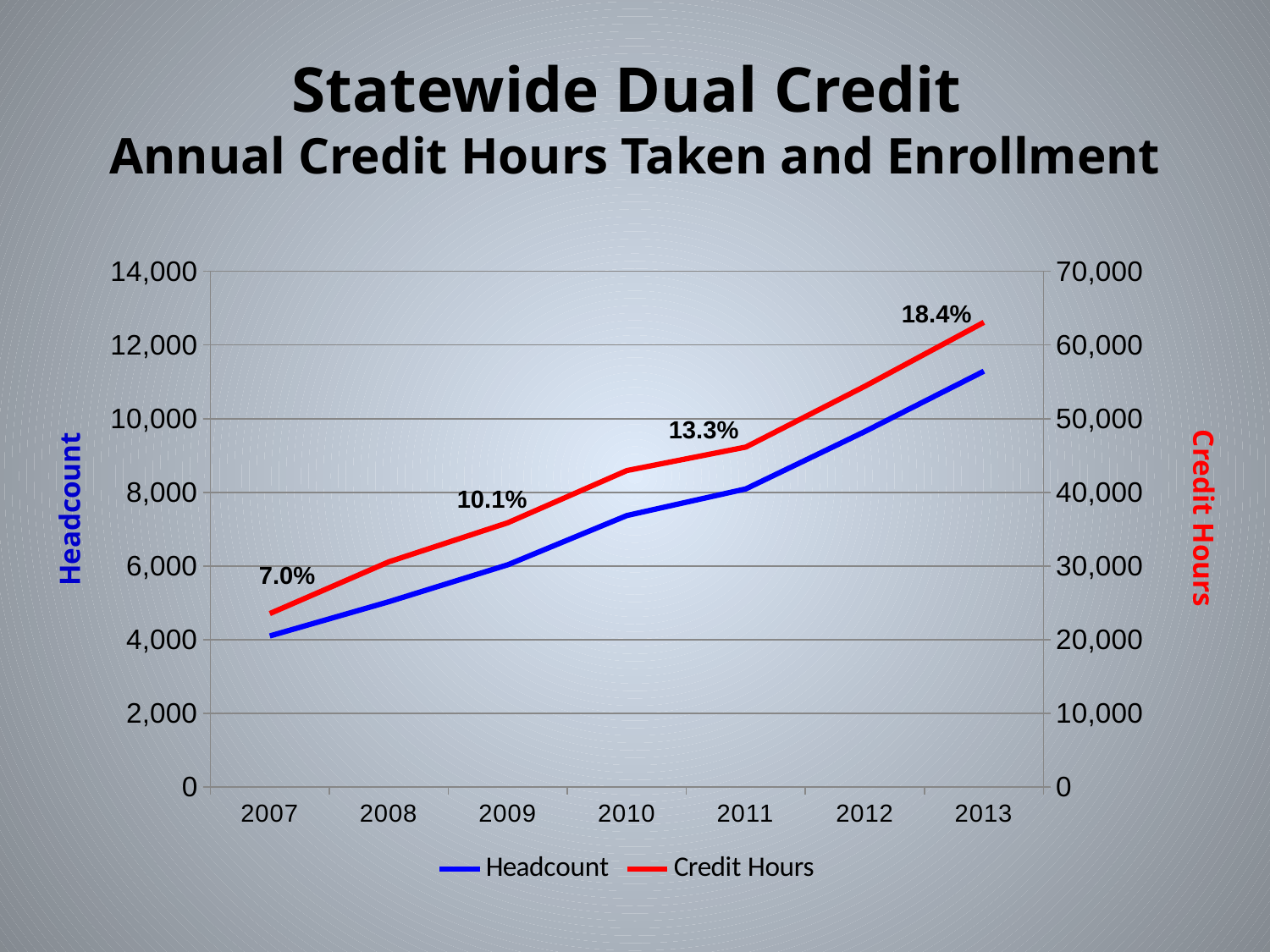
What kind of chart is shown on the slide? line chart Which colour is used for the Credit Hours line? red Is the Credit Hours value for 2013 greater or less than 60,000? greater Is the Headcount value for 2013 greater or less than 10,000? greater How many series does the legend list? 2 Do the Headcount values rise or fall from 2007 to 2013? rise Is the Headcount value for 2010 greater or less than 8,000? less In which year is Headcount lowest? 2007 In which year is Credit Hours highest? 2013 How many years are plotted along the x axis? 7 What percentage label is shown on the chart at 2011? 13.3%